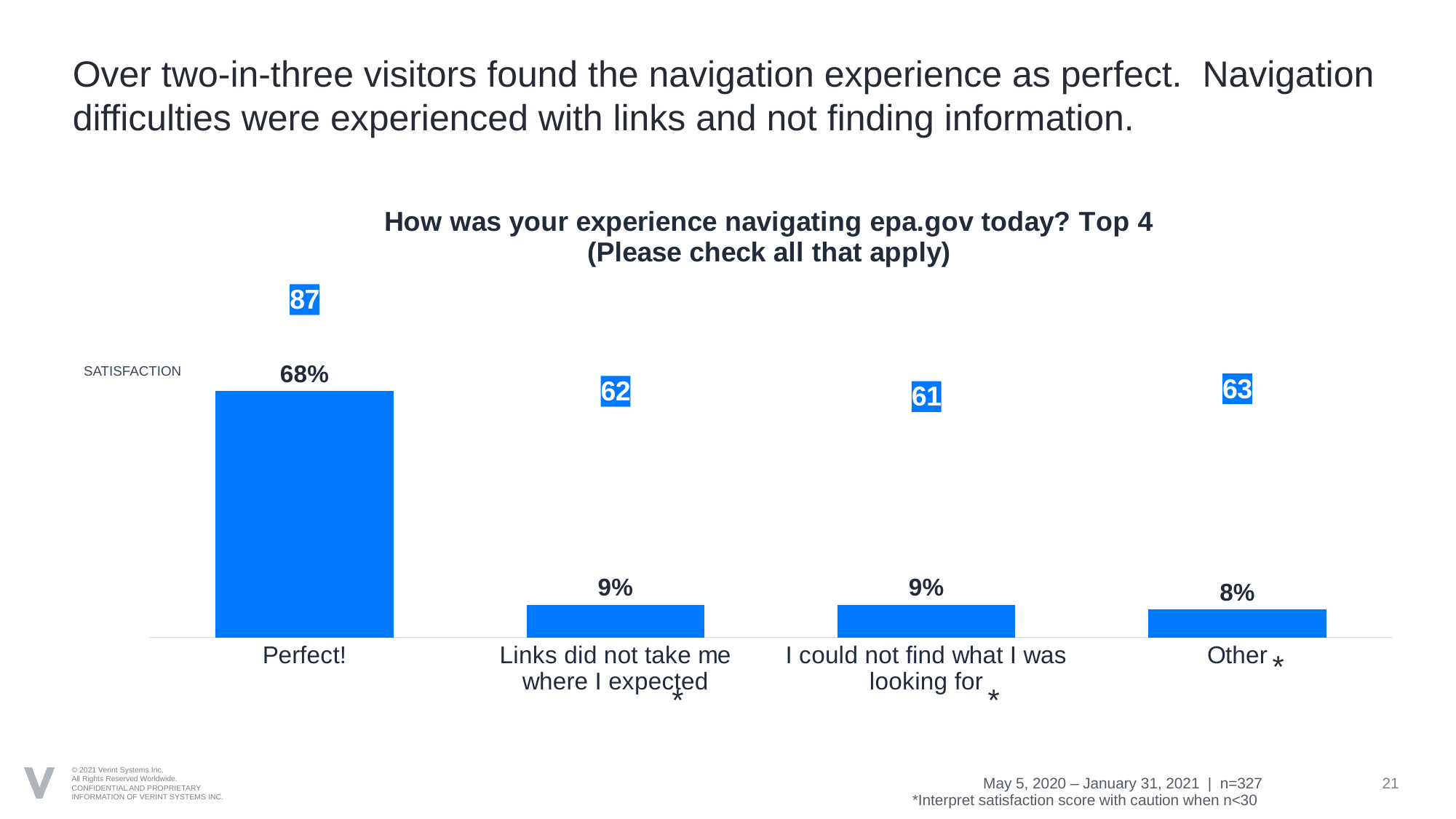
What is the title of the chart? How was your experience navigating epa.gov today? Top 4 (Please check all that apply) What is the difference in percentage points between "Perfect!" and "Links did not take me where I expected"? 59 What percentage of visitors selected "Other"? 8% Which category has the highest percentage of visitors? Perfect! What is the sample size (n) noted at the bottom of the slide? n=327 What percentage of visitors selected "Perfect!"? 68% How many categories are shown in the chart? 4 Which has a higher satisfaction score, "Links did not take me where I expected" or "Other"? Other What is the satisfaction score shown above the "Perfect!" bar? 87 Which category has the lowest percentage of visitors? Other What kind of chart is shown on the slide? Bar chart What is the satisfaction score shown for "I could not find what I was looking for"? 61